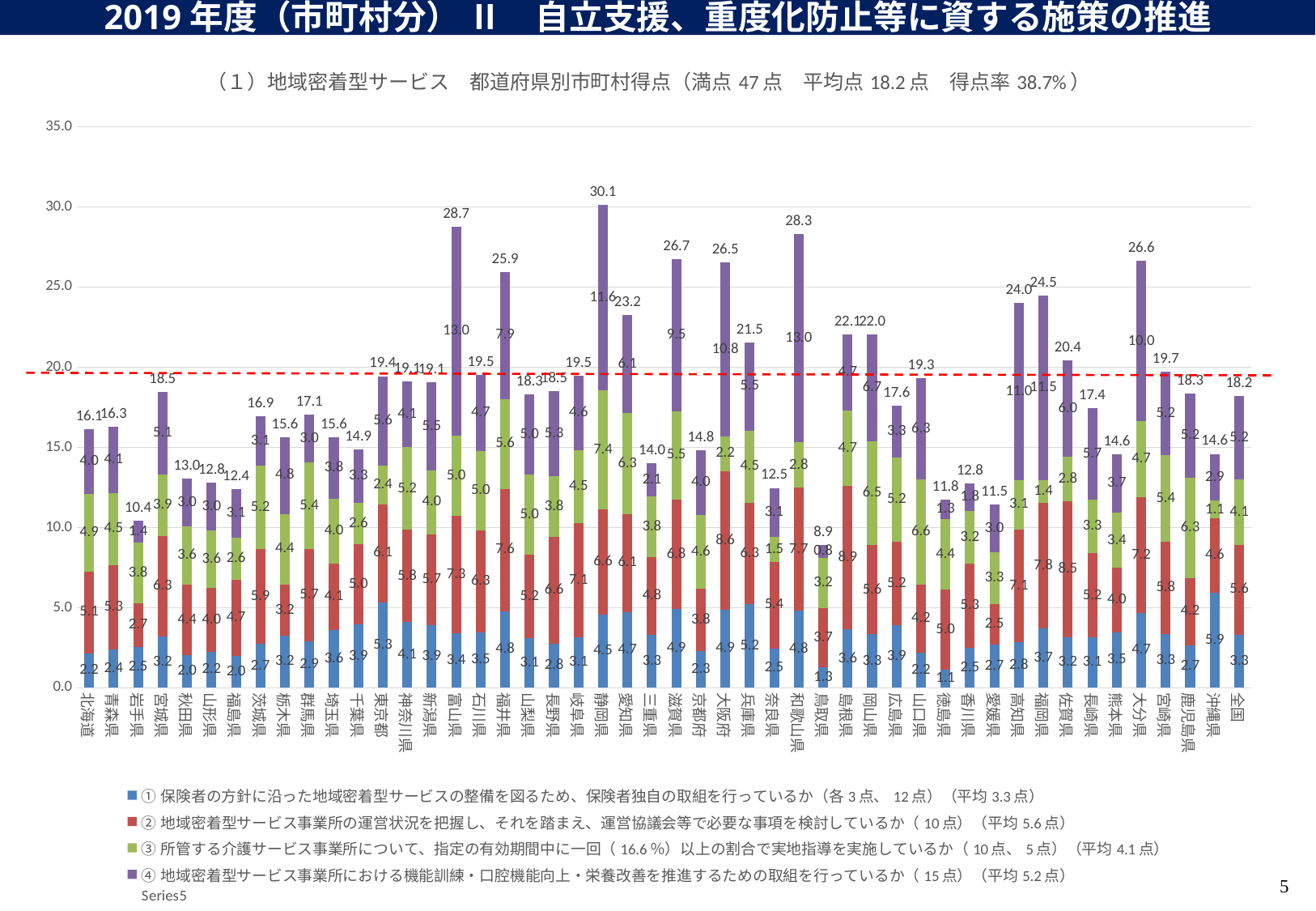
What is the difference between the total scores of 全国 and 北海道? 2.1 What is the difference between the total scores of 静岡県 and 鳥取県? 21.2 Which prefecture has the highest total score in the chart? 静岡県 Is the total score for 岩手県 greater or less than 15.0? less Which prefecture has the lowest total score in the chart? 鳥取県 Which has a higher total score, 富山県 or 和歌山県? 富山県 What kind of chart is shown on the slide? Stacked bar chart What is the total score for 全国? 18.2 What is the average score (平均点) stated in the chart title? 18.2 点 What is the total score for 富山県? 28.7 What is the value of the ② (red) segment for 全国? 5.6 What is the total score for 静岡県? 30.1